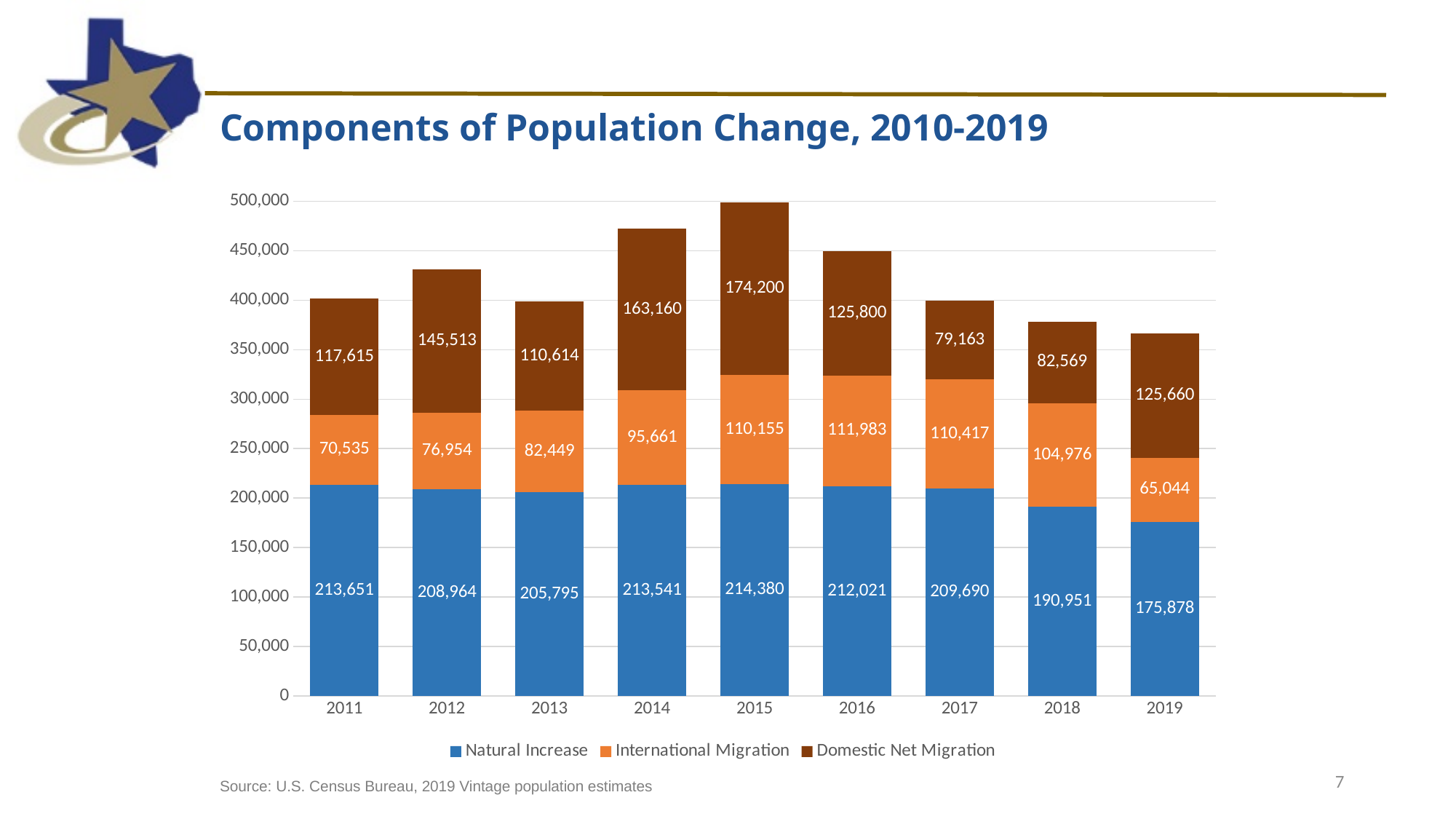
What is the total of the stacked bar for 2015? 498,735 Which is larger: International Migration in 2016 or in 2011? 2016 Is the total height of the 2014 stacked bar greater or less than 450,000? greater What is the Domestic Net Migration value for 2012? 145,513 In which year is Natural Increase lowest? 2019 What is the International Migration value for 2019? 65,044 How many series does the legend list? 3 What is the Natural Increase value for 2015? 214,380 In which year is Domestic Net Migration highest? 2015 What kind of chart is shown on the slide? Stacked bar chart What is the difference between Domestic Net Migration in 2015 and in 2017? 95,037 How many years are shown on the x axis? 9